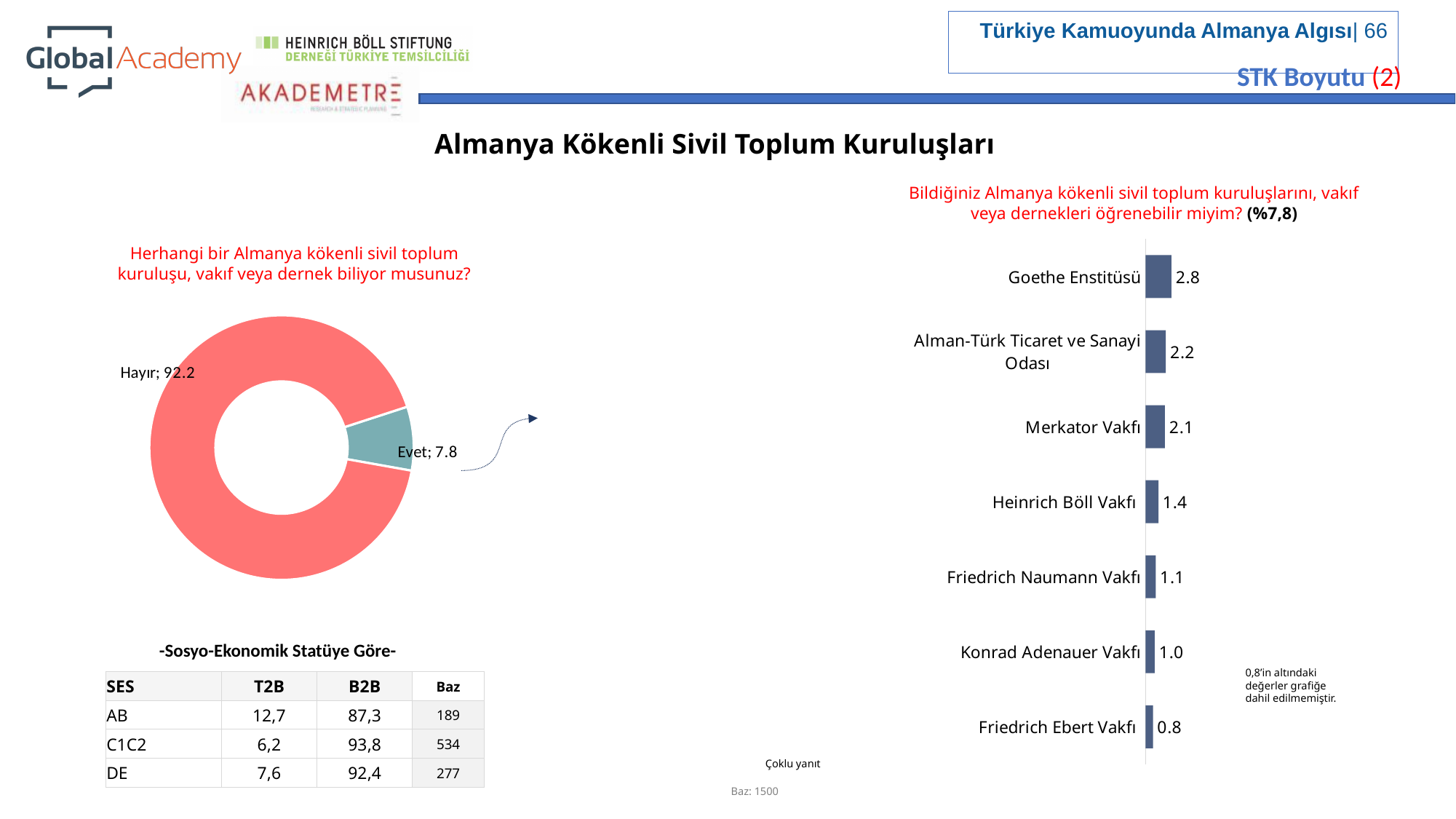
What kind of chart is shown on the right side of the slide? Bar chart In the bar chart on the right, what is the difference between the values for Goethe Enstitüsü and Merkator Vakfı? 0.7 In the donut chart on the left, what is the difference between the Hayır and Evet values? 84.4 In the bar chart on the right, which organization has the lowest value? Friedrich Ebert Vakfı In the donut chart on the left, which slice is larger, Hayır or Evet? Hayır In the donut chart on the left, what is the value for Evet? 7.8 What kind of chart is shown on the left side of the slide? Pie (donut) chart In the bar chart on the right, how many organizations are shown? 7 In the bar chart on the right, which organization has the highest value? Goethe Enstitüsü In the bar chart on the right, what is the value for Goethe Enstitüsü? 2.8 In the donut chart on the left, what is the value for Hayır? 92.2 In the bar chart on the right, what is the value for Heinrich Böll Vakfı? 1.4